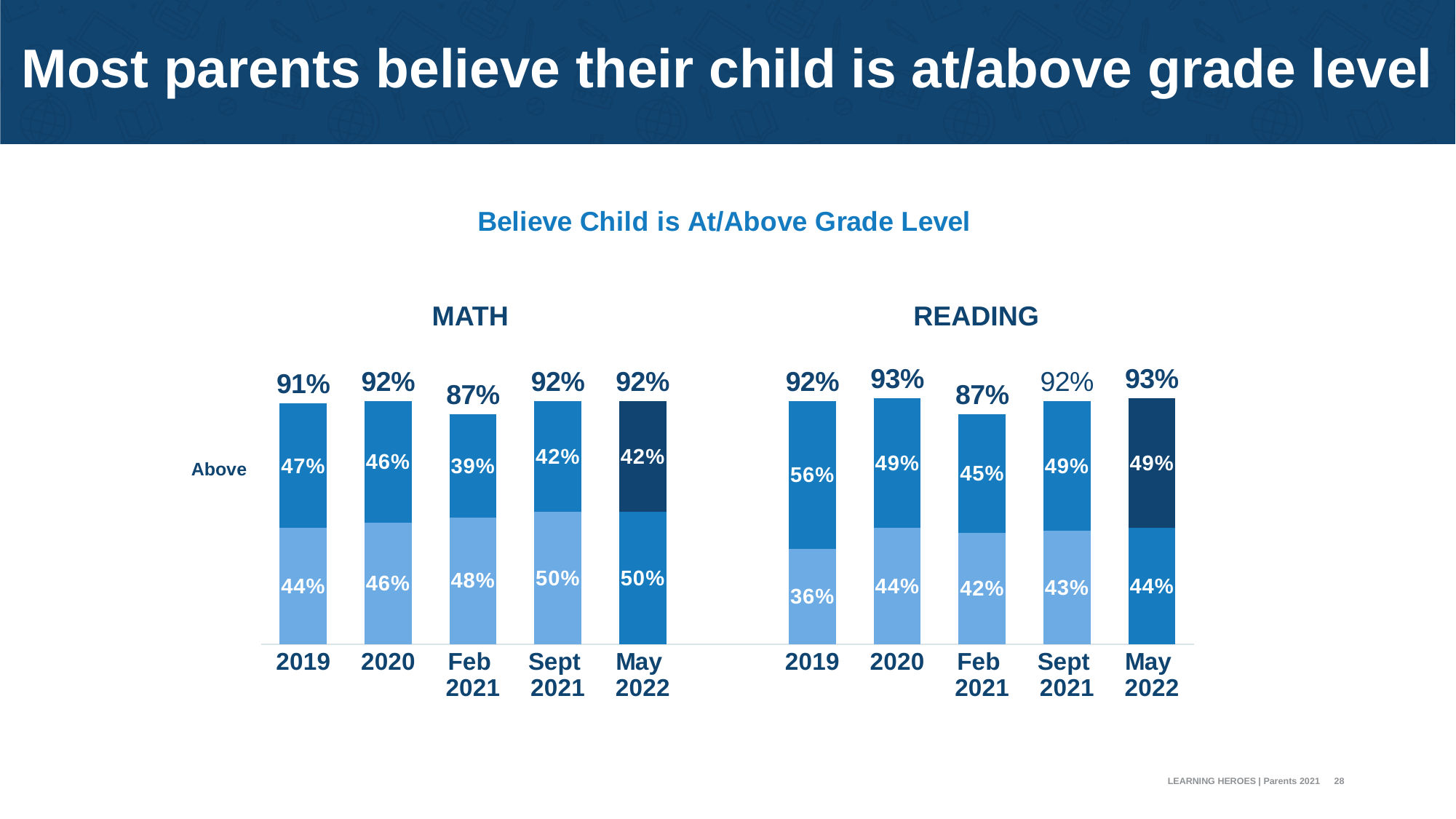
What is the title shown above the two charts? Believe Child is At/Above Grade Level In the MATH chart, is the 'Above' value for 2020 larger or smaller than the 'Above' value for Feb 2021? larger What type of chart is used for the READING data? Stacked bar chart In the READING chart, what is the difference between the 'Above' value for 2019 and the 'Above' value for May 2022? 7% In the MATH chart, which time point has the highest 'Above' value? 2019 In the MATH chart, what is the total percentage shown above the bar for Feb 2021? 87% In the READING chart, does the 'Above' value rise or fall from 2019 to Feb 2021? Fall In the READING chart, which time point has the lowest total percentage? Feb 2021 In the READING chart, what is the 'Above' value for 2019? 56% How many time points are shown on the x axis of the MATH chart? 5 In the MATH chart, what is the total of the two segments for May 2022? 92% In the MATH chart, what is the value of the bottom segment for Sept 2021? 50%